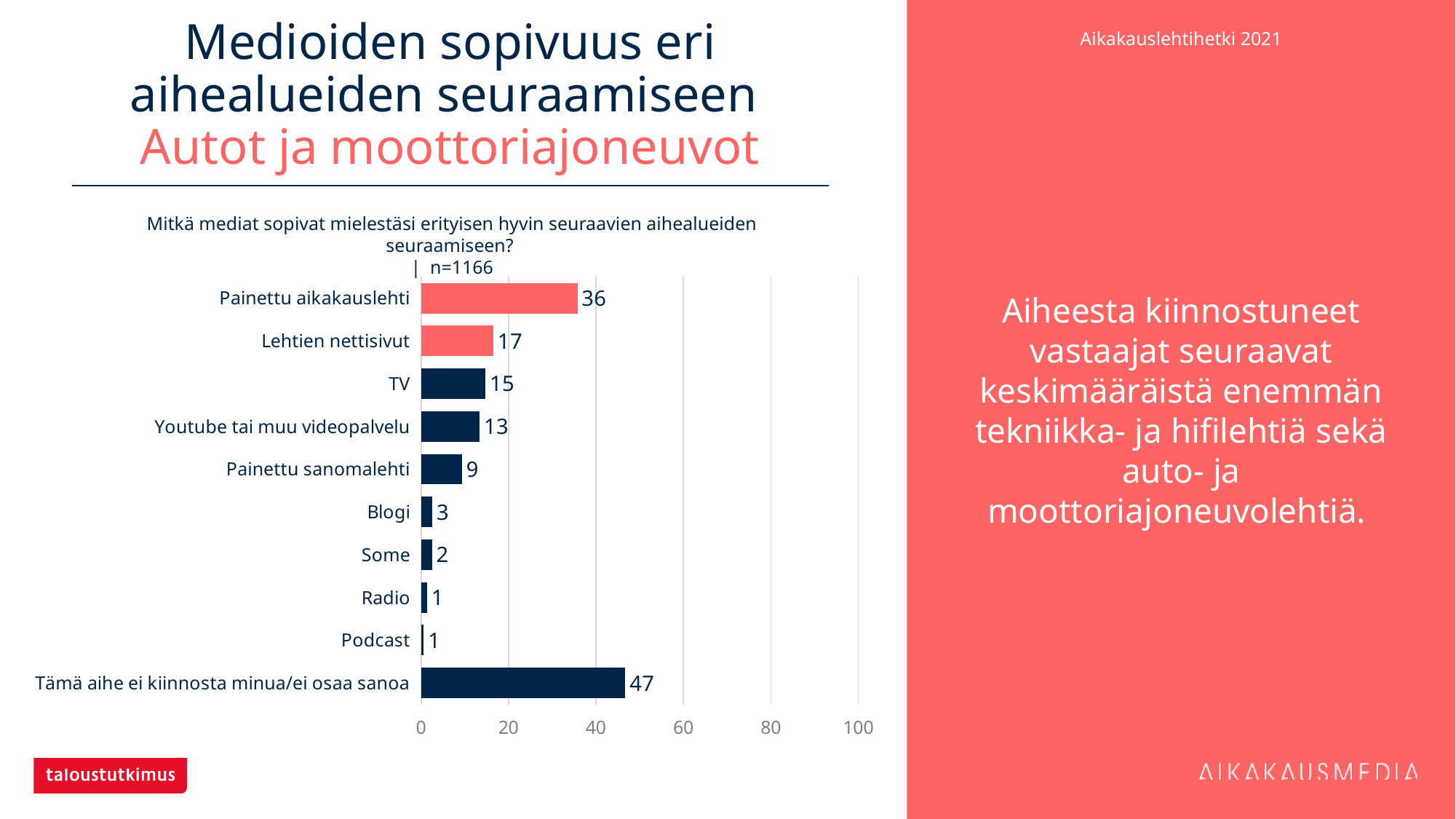
Which category has the lowest value among the media options, excluding the ties at 1? Some What is the value for Youtube tai muu videopalvelu? 13 How many categories are shown in the chart? 10 What is the value for Tämä aihe ei kiinnosta minua/ei osaa sanoa? 47 What is the value for Painettu aikakauslehti? 36 Is the value for Tämä aihe ei kiinnosta minua/ei osaa sanoa greater or less than 40? greater Which is larger, the value for TV or the value for Painettu sanomalehti? TV What is the sample size (n) stated above the chart? n=1166 Which category has the highest value? Tämä aihe ei kiinnosta minua/ei osaa sanoa What is the value for Lehtien nettisivut? 17 What kind of chart is shown on the slide? bar chart What is the difference between the values for Painettu aikakauslehti and Lehtien nettisivut? 19